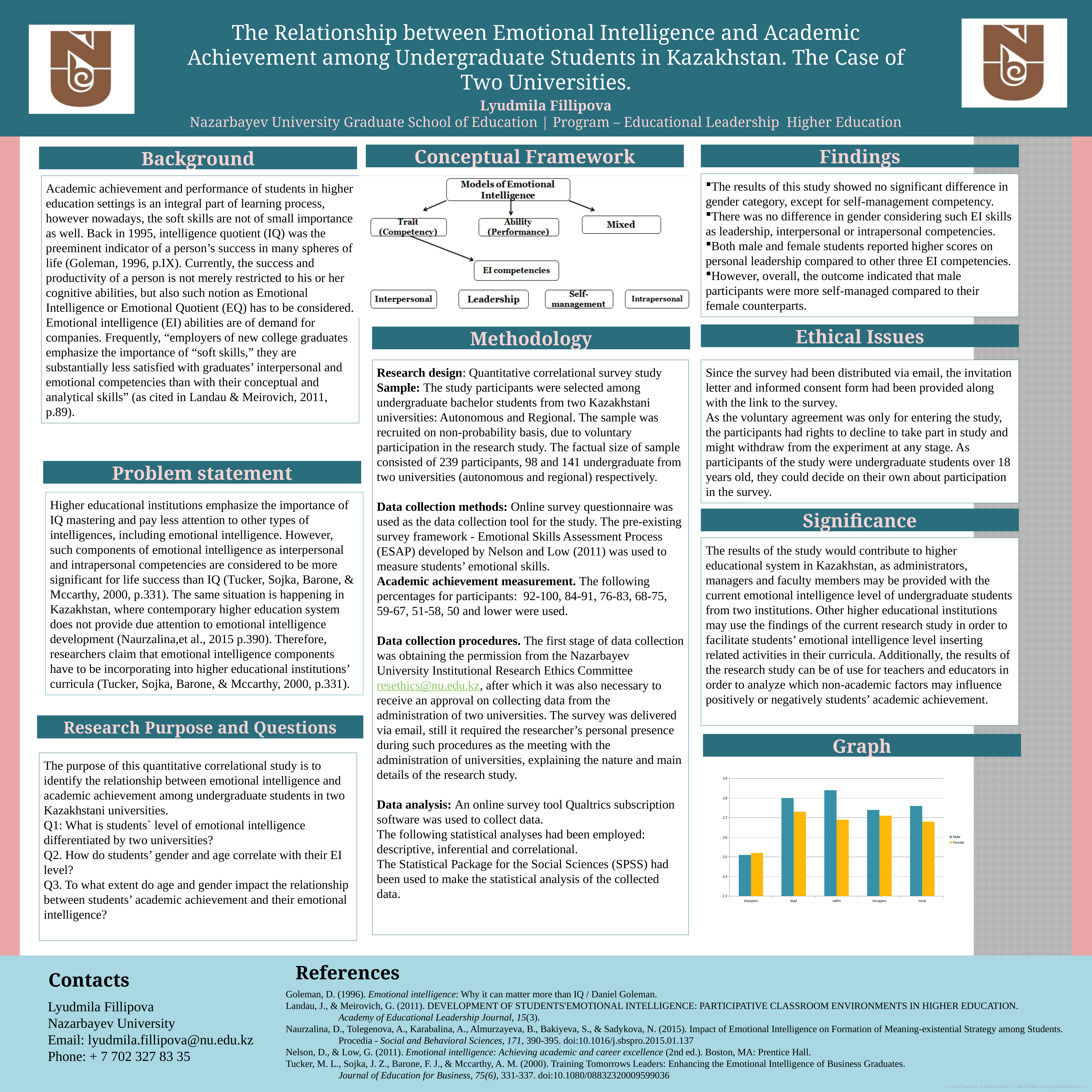
What kind of chart is shown under the "Graph" heading? bar chart How many categories are shown on the x axis of the Graph chart? 5 In the Graph chart, which category has the lowest Female value? interpers In the Graph chart, is the Male or the Female value larger for selfm? Male In the Graph chart, which category has the highest Male value? selfm In the Graph chart, which category has the lowest Male value? interpers In the Graph chart, is the Male value for selfm greater or less than 2.8? greater In the Graph chart, is the Male or the Female value larger for total? Male In the Graph chart, is the Male value for interpers greater or less than 2.6? less In the Graph chart, which colour represents the Female series? yellow In the Graph chart, is the Female value for lead greater or less than 2.7? greater How many series does the legend of the Graph chart list? 2